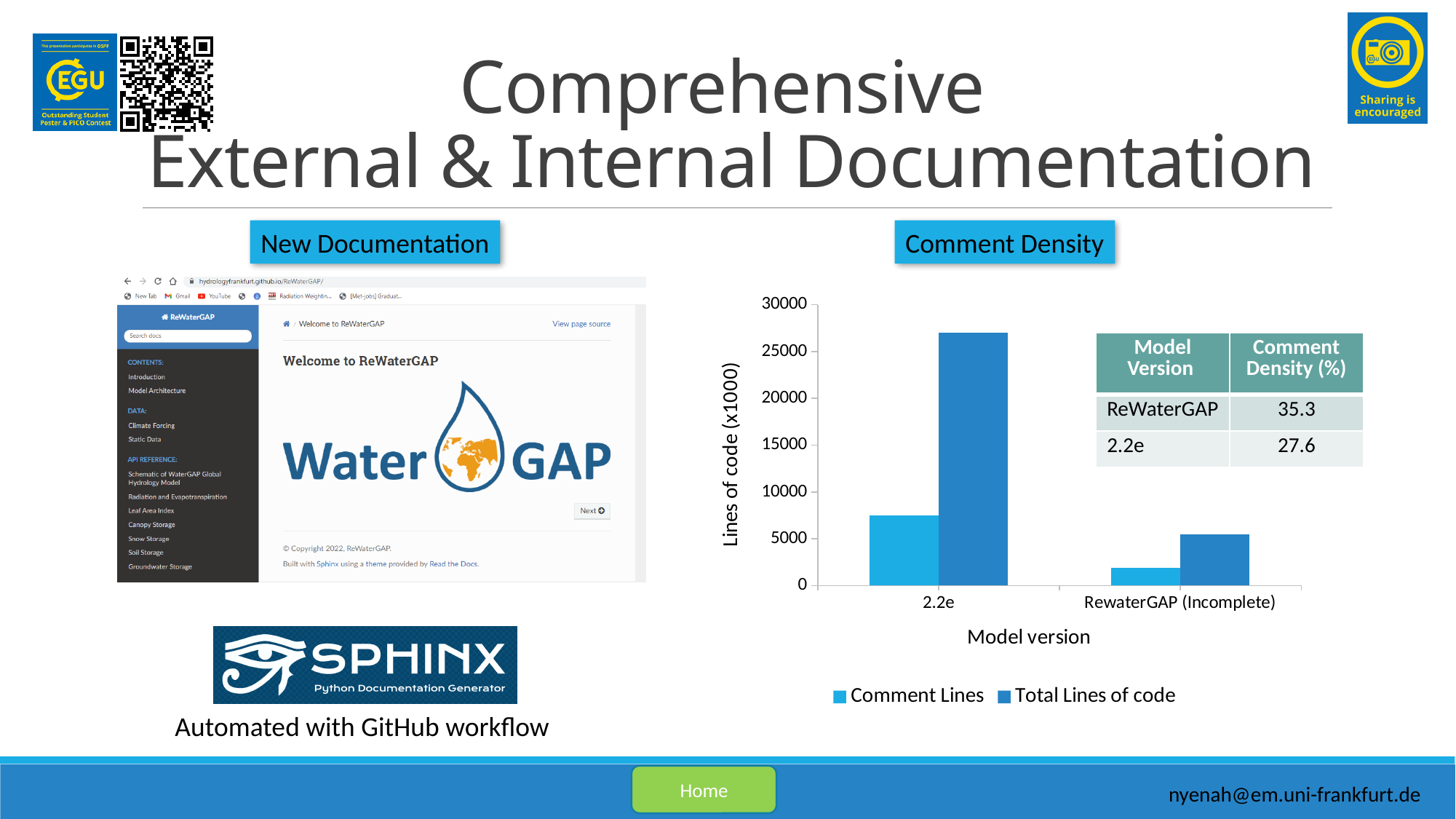
In the Comment Density chart, which model version has the higher Total Lines of code? 2.2e In the Comment Density chart, is the Comment Lines value for 2.2e greater or less than 5000? greater In the Comment Density chart, is the Comment Lines value for RewaterGAP (Incomplete) greater or less than 5000? less How many series does the legend of the Comment Density chart list? 2 What are the two series named in the legend of the Comment Density chart? Comment Lines and Total Lines of code In the Comment Density chart, which model version has the lower Comment Lines value? RewaterGAP (Incomplete) In the Comment Density chart, is the Comment Lines value for 2.2e greater or less than 10000? less What is the y-axis label of the Comment Density chart? Lines of code (x1000) How many model versions are shown on the x axis of the Comment Density chart? 2 What kind of chart is shown under the Comment Density heading? bar chart